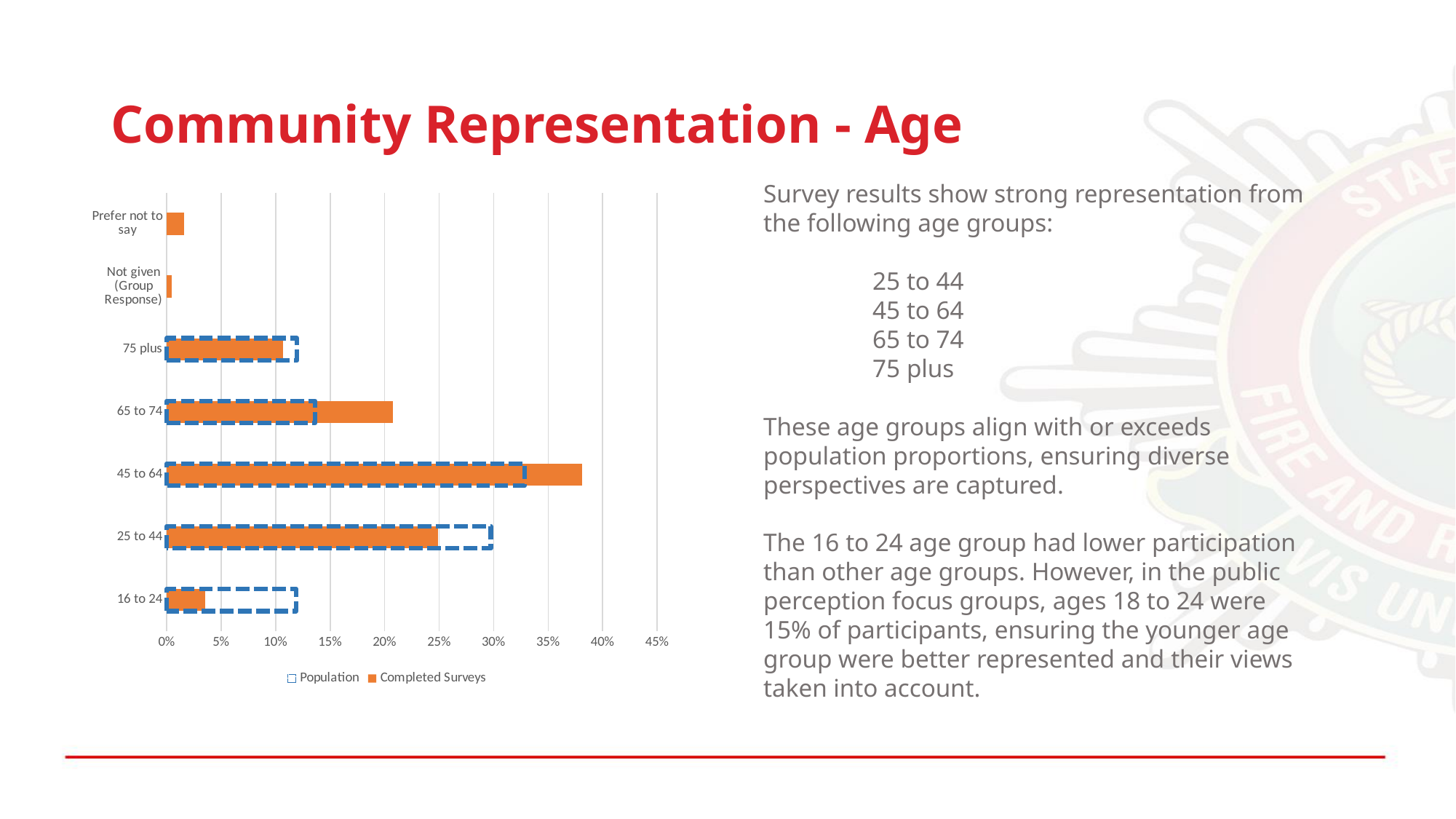
Which category has the highest Completed Surveys value? 45 to 64 Which category has the highest Population value? 45 to 64 For the 25 to 44 age group, which is larger: Population or Completed Surveys? Population For the 65 to 74 age group, which is larger: Population or Completed Surveys? Completed Surveys Which series is shown with a dashed blue outline in the legend? Population Which category has the lowest Completed Surveys value? Not given (Group Response) Is the Population value for 25 to 44 greater or less than 25%? greater What kind of chart is shown on the slide? Bar chart How many series does the chart legend list? 2 How many categories are shown on the chart's vertical axis? 7 Is the Completed Surveys value for 16 to 24 greater or less than 5%? less Is the Completed Surveys value for 45 to 64 greater or less than 35%? greater